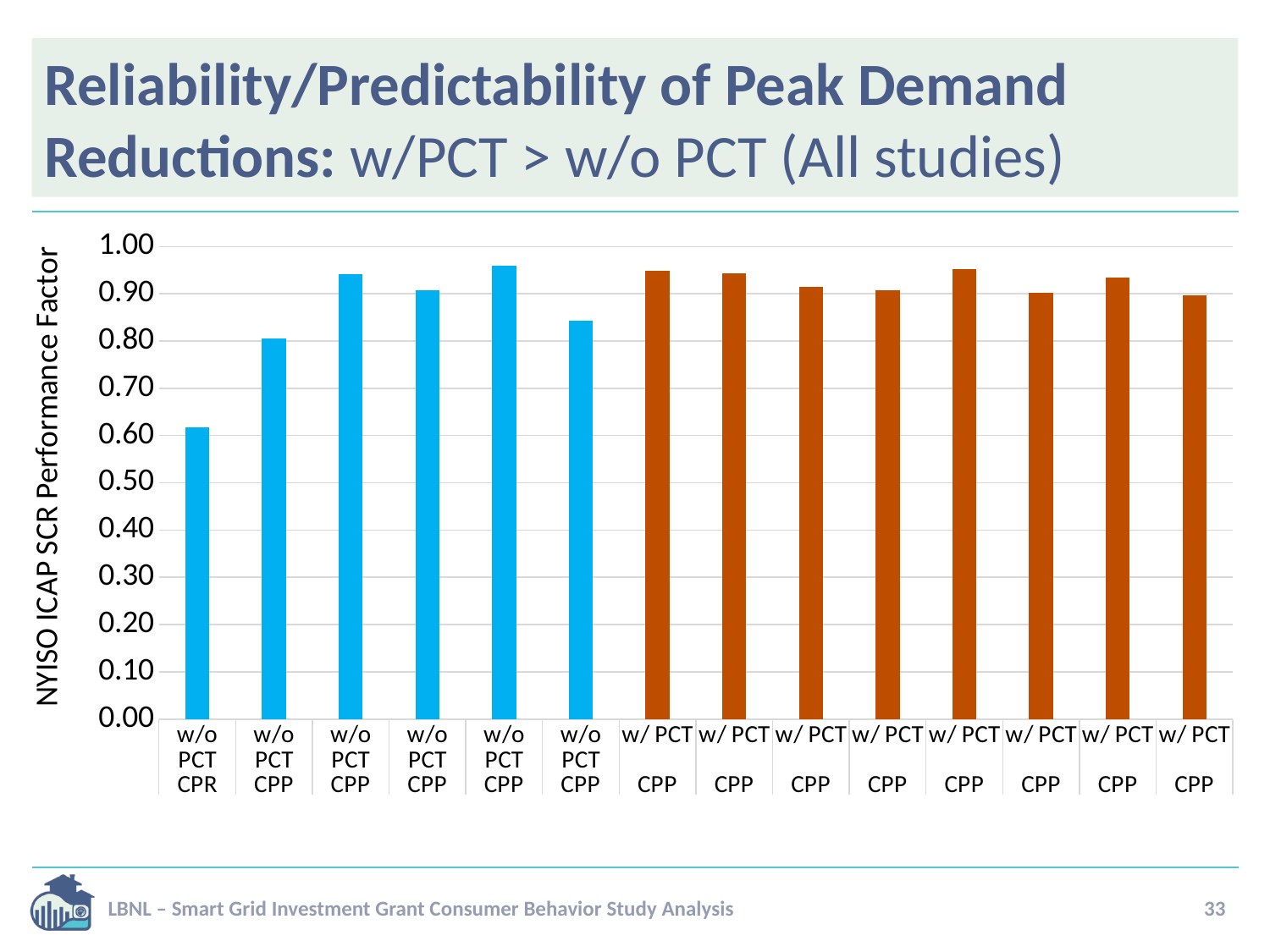
What colour are the w/ PCT bars in the chart? orange-brown Which is larger, the value for the w/o PCT CPR bar or the value for the first w/o PCT CPP bar next to it? the first w/o PCT CPP bar Is the value for the w/o PCT CPR bar greater or less than 0.70? less Which bar has the lowest NYISO ICAP SCR Performance Factor? w/o PCT CPR What kind of chart is shown on the slide? bar chart Is the value for the first w/ PCT CPP bar (seventh bar from the left) greater or less than 0.90? greater How many bars are labelled "w/ PCT"? 8 What is the label on the vertical axis of the chart? NYISO ICAP SCR Performance Factor How many bars are labelled "w/o PCT"? 6 Is the value for the last w/o PCT CPP bar (sixth bar from the left) greater or less than 0.90? less How many bars are plotted in the chart? 14